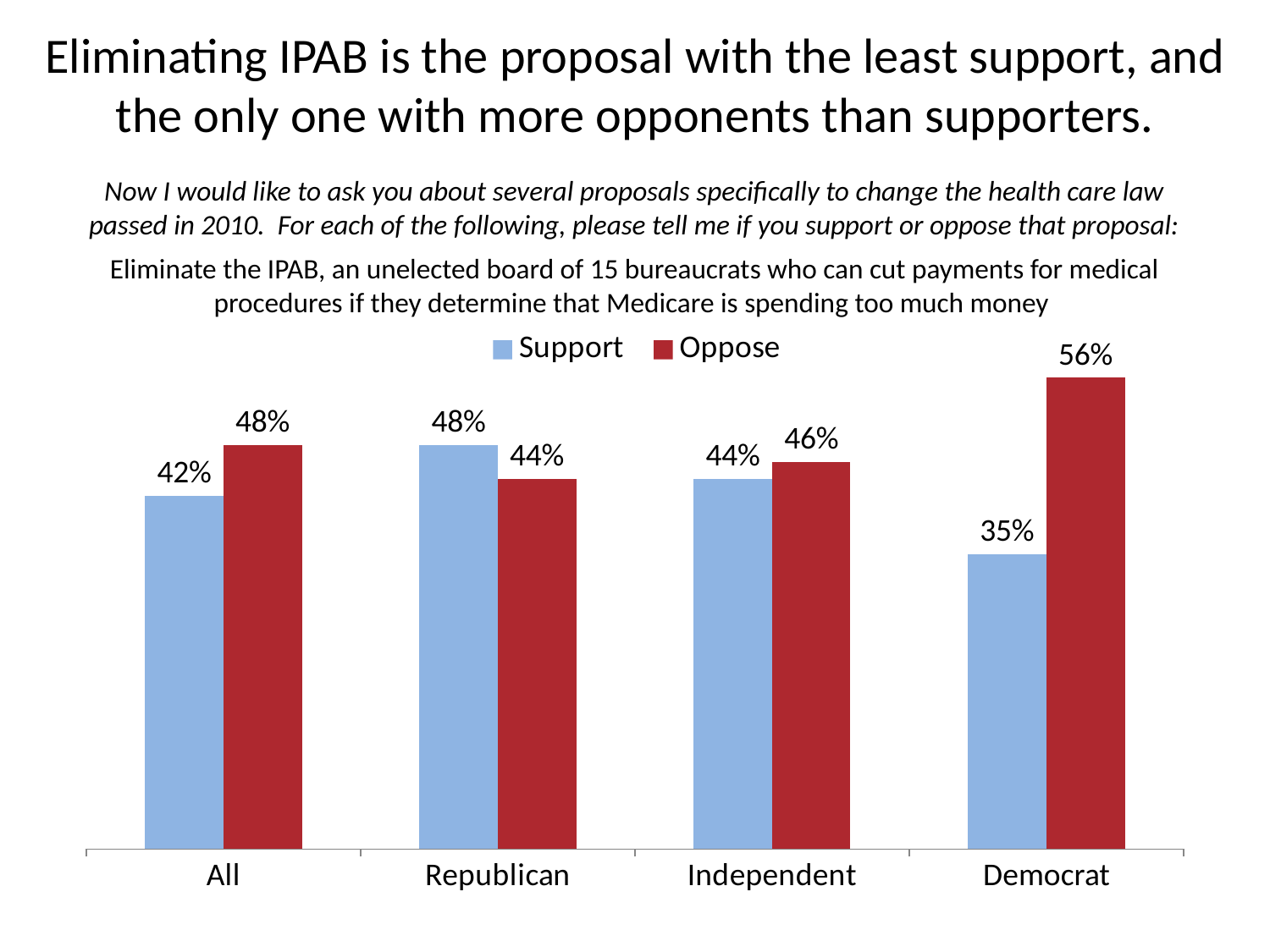
What is the Support value for Republicans? 48% Which colour represents the Oppose series? Red What percentage of Democrats oppose eliminating the IPAB? 56% What kind of chart is shown on the slide? Bar chart Which category has the highest Oppose value? Democrat Which category has the lowest Support value? Democrat What is the Oppose value for the All category? 48% What is the Support value for Independents? 44% How many series does the legend list? 2 What is the difference between the Oppose and Support values for Democrats? 21% How many categories are shown on the x axis? 4 For Republicans, which is larger: Support or Oppose? Support